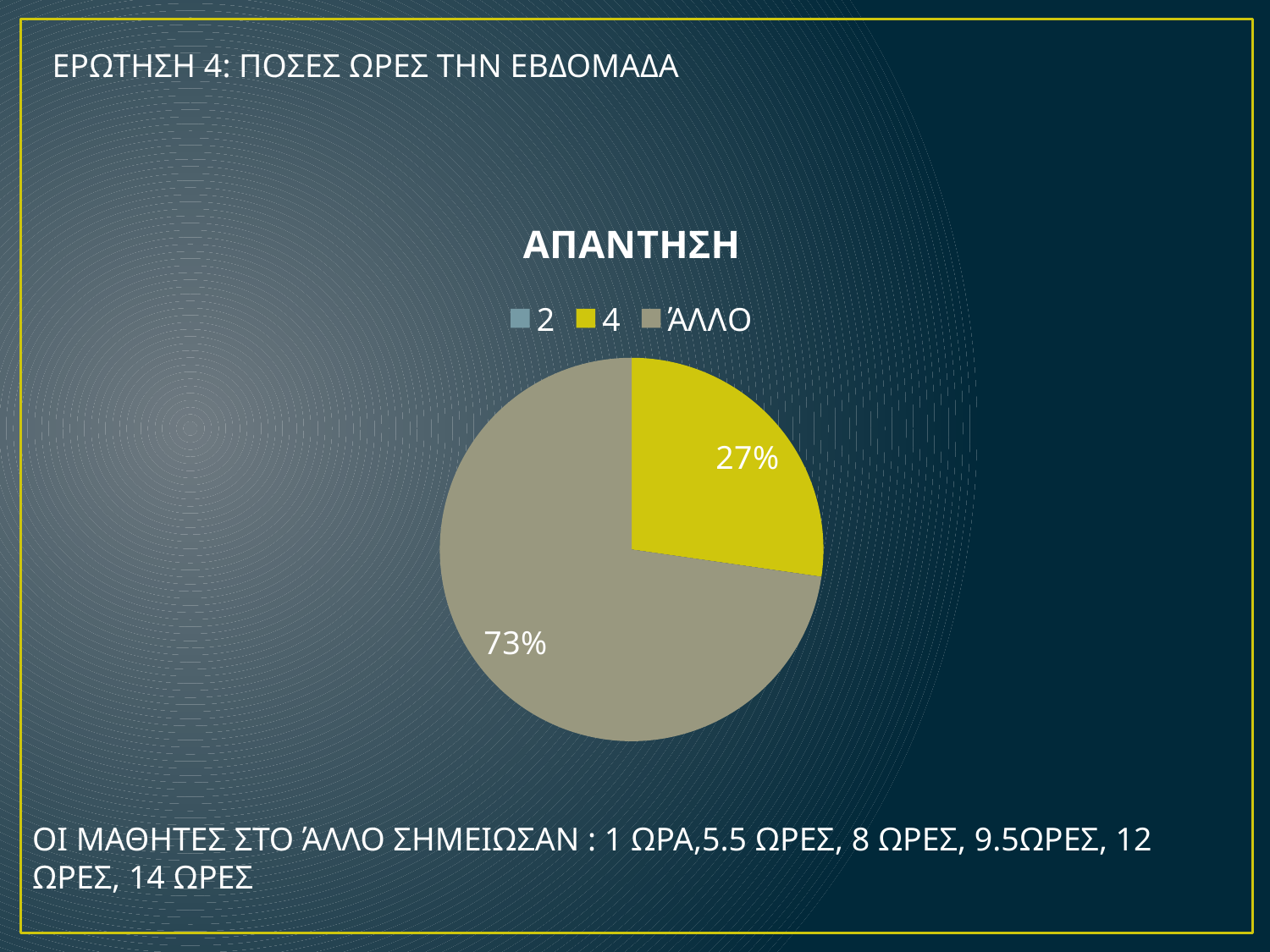
What is the title of the chart? ΑΠΑΝΤΗΣΗ What colour is the slice for category 4? yellow What kind of chart is shown on the slide? pie chart What is the difference in percentage points between the ΆΛΛΟ slice and the slice for 4? 46% Which legend entry is listed first in the chart legend? 2 What is the combined share of the slices labelled 27% and 73%? 100% Which is larger, the slice for 4 or the slice for ΆΛΛΟ? ΆΛΛΟ Which category has the largest slice of the pie? ΆΛΛΟ How many entries does the chart legend list? 3 What share of the pie does the slice for 4 represent? 27% What share of the pie does the ΆΛΛΟ slice represent? 73%